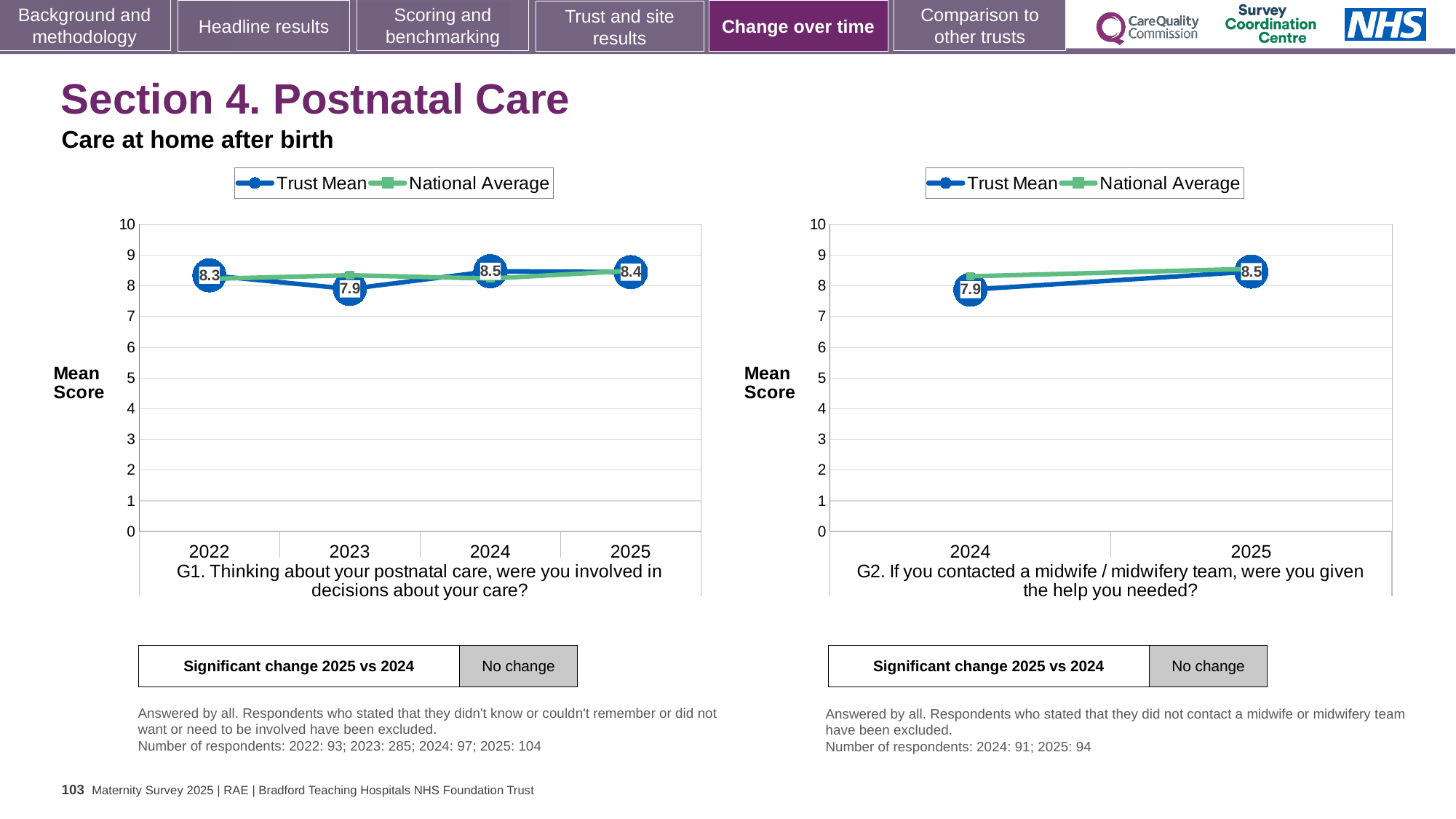
How many years are plotted on the x axis of the G1 chart (left)? 4 In the G2 chart (right), what is the Trust Mean for 2024? 7.9 In the G2 chart (right), what is the difference between the Trust Mean for 2025 and 2024? 0.6 In the G1 chart (left), which year has the lowest Trust Mean? 2023 In the G2 chart (right), does the Trust Mean rise or fall from 2024 to 2025? Rise In the G1 chart (left), what is the Trust Mean for 2023? 7.9 In the G2 chart (right), is the National Average for 2024 greater or less than 7? greater How many series does the legend of the G2 chart (right) list? 2 In the G1 chart (left), is the Trust Mean higher in 2022 or 2023? 2022 In the G1 chart (left), which year has the highest Trust Mean? 2024 What type of chart is the G1 chart (left)? Line chart In the G1 chart (left), what is the Trust Mean for 2025? 8.4